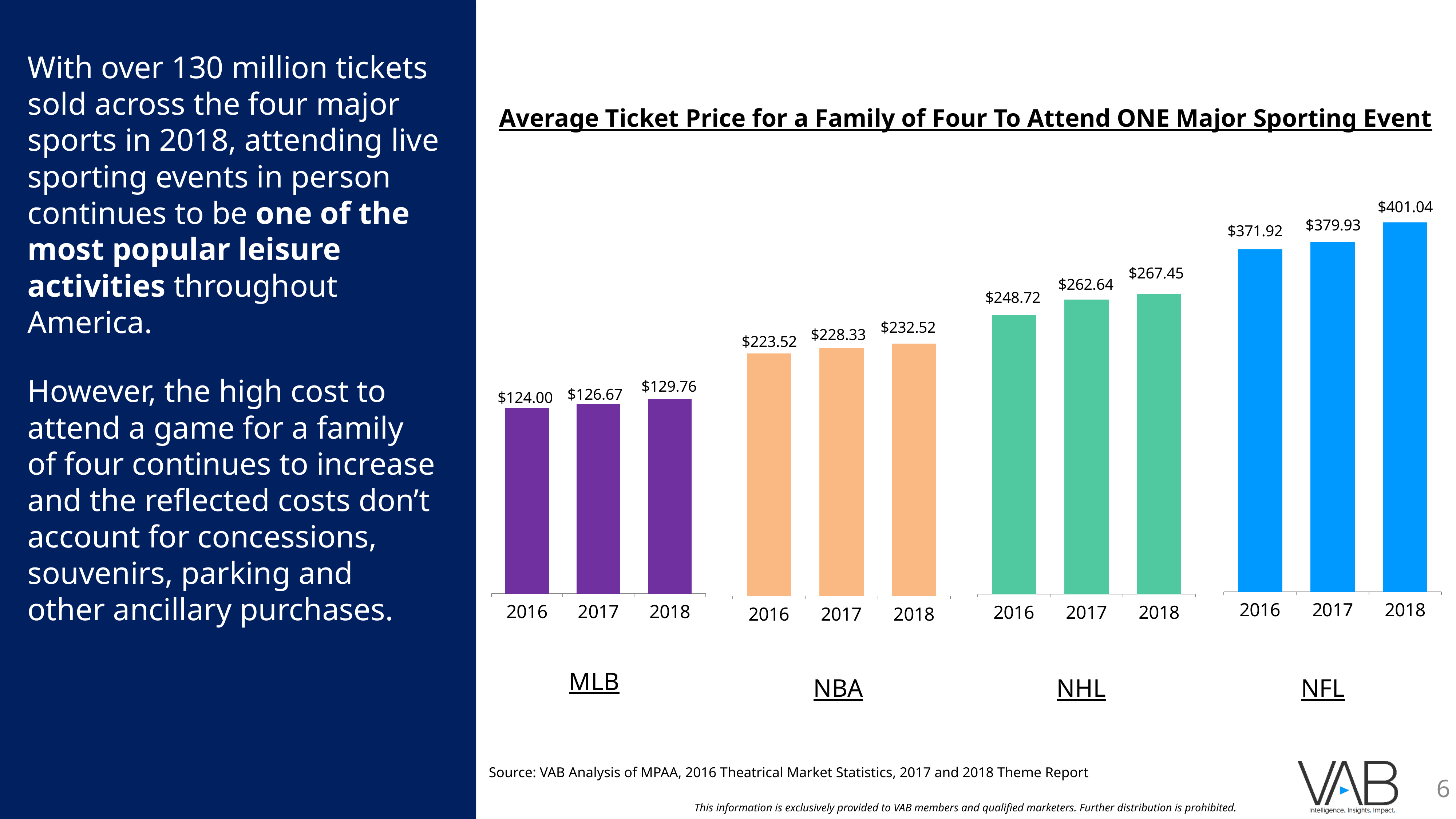
In the NBA chart, what is the average ticket price for 2018? $232.52 In the MLB chart, what is the average ticket price for 2016? $124.00 What kind of chart is used for the NHL data? bar chart Which is larger: the NBA 2018 average ticket price or the NHL 2016 average ticket price? NHL 2016 In the MLB chart, do the average ticket prices rise or fall from 2016 to 2018? rise In the MLB chart, what is the difference between the 2018 and 2016 average ticket prices? $5.76 In the NFL chart, which year has the highest average ticket price? 2018 How many years are shown in the NBA chart? 3 In the NFL chart, what is the difference between the 2018 and 2016 average ticket prices? $29.12 In the NFL chart, what is the average ticket price for 2018? $401.04 In the NHL chart, what is the average ticket price for 2017? $262.64 In the NHL chart, which year has the lowest average ticket price? 2016